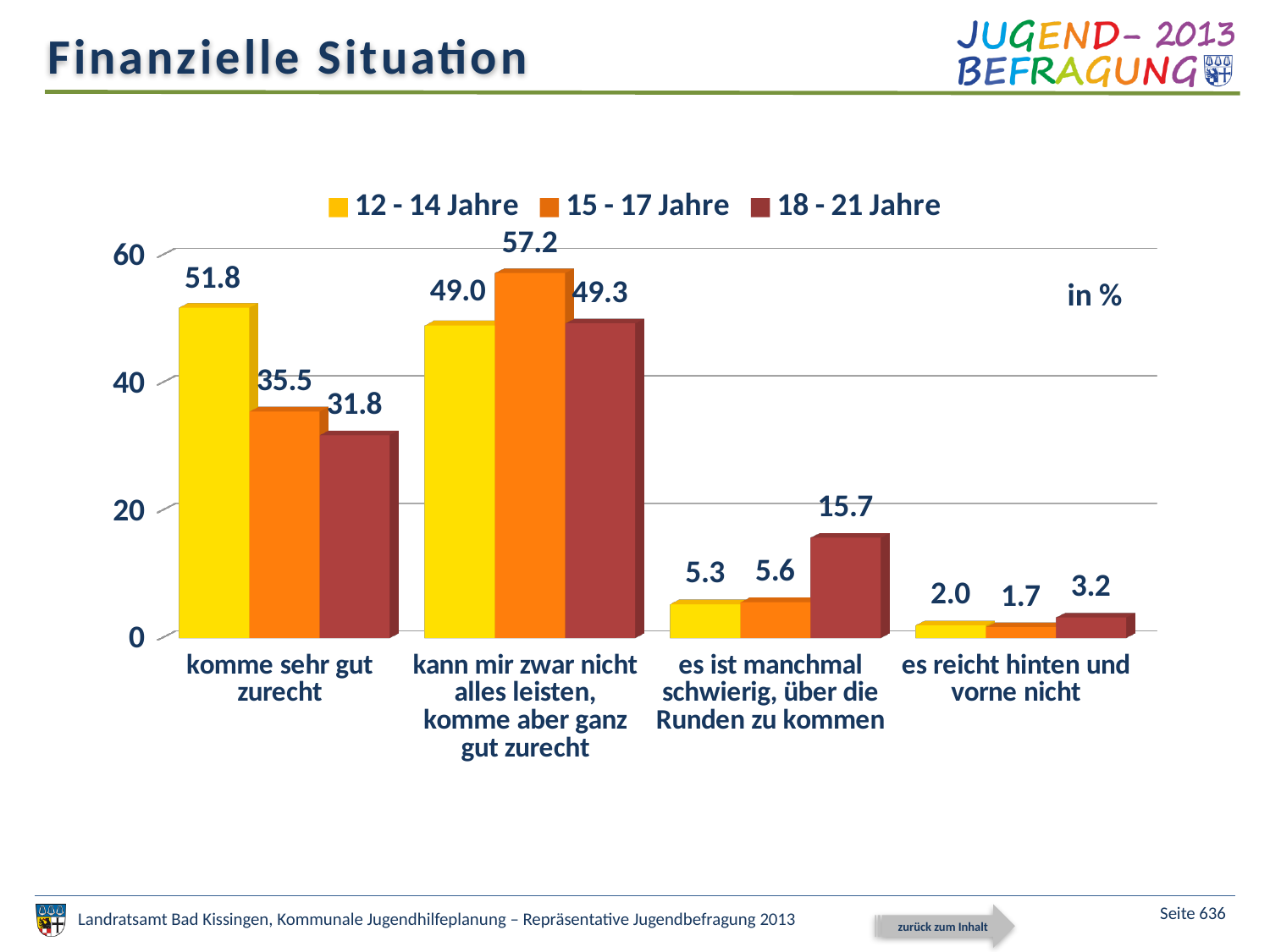
What is the value for the 18 - 21 Jahre series in the category "es ist manchmal schwierig, über die Runden zu kommen"? 15.7 Which series has the highest value in the category "komme sehr gut zurecht"? 12 - 14 Jahre What is the difference between the 12 - 14 Jahre and 18 - 21 Jahre values in the category "komme sehr gut zurecht"? 20.0 Is the value for 15 - 17 Jahre in the category "komme sehr gut zurecht" greater or less than 40? less How many categories are shown on the x axis? 4 Which category has the lowest value for the 18 - 21 Jahre series? es reicht hinten und vorne nicht How many series does the legend list? 3 What is the value for the 15 - 17 Jahre series in the category "es reicht hinten und vorne nicht"? 1.7 What is the value for the 15 - 17 Jahre series in the category "kann mir zwar nicht alles leisten, komme aber ganz gut zurecht"? 57.2 What is the value for the 12 - 14 Jahre series in the category "komme sehr gut zurecht"? 51.8 Which is larger in the category "kann mir zwar nicht alles leisten, komme aber ganz gut zurecht": the 12 - 14 Jahre value or the 18 - 21 Jahre value? 18 - 21 Jahre What kind of chart is shown on the slide? bar chart